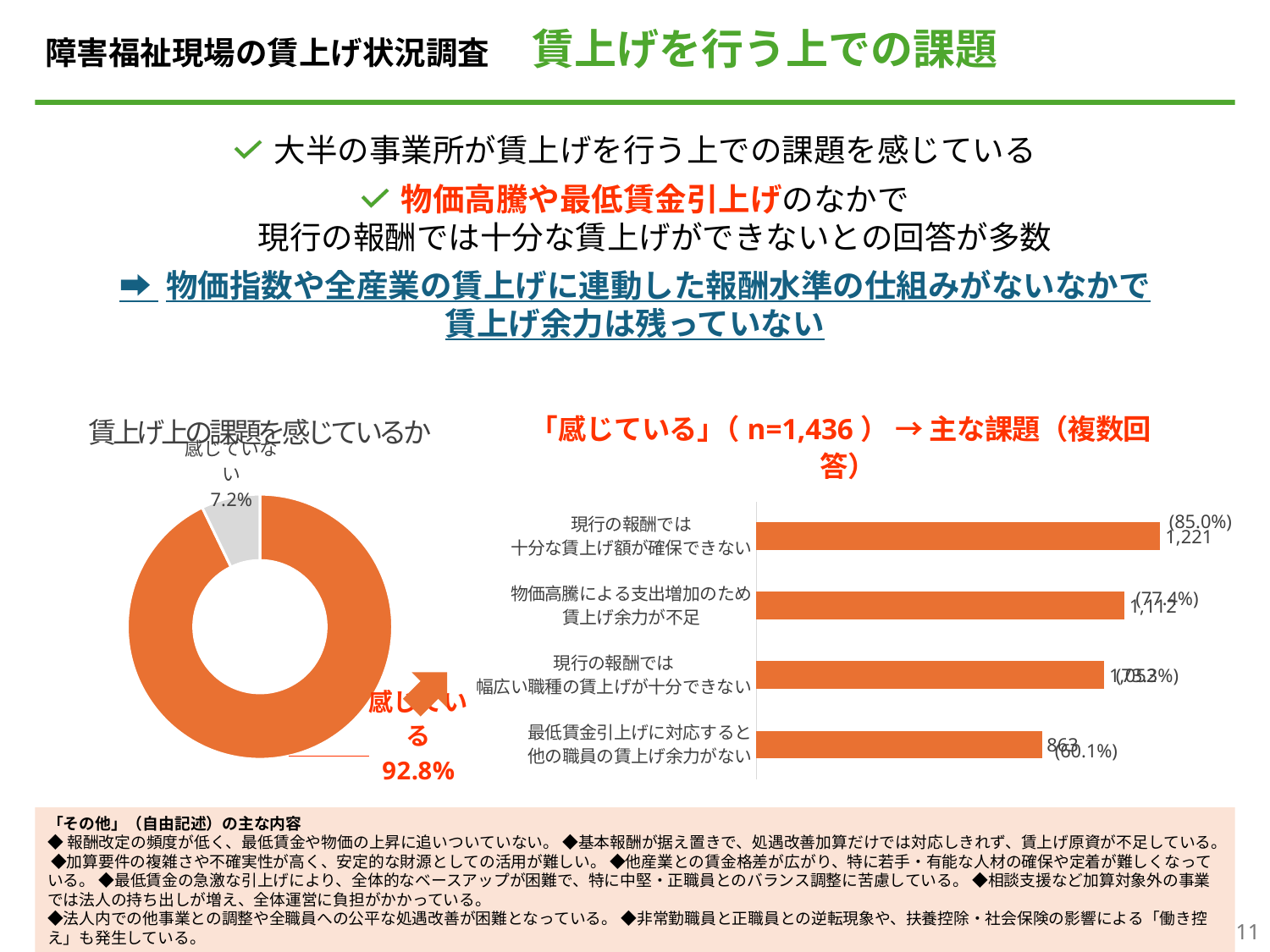
In the bar chart on the right (主な課題), what is the count for 最低賃金引上げに対応すると他の職員の賃上げ余力がない? 863 In the bar chart on the right (主な課題), which category has the lowest count? 最低賃金引上げに対応すると他の職員の賃上げ余力がない How many categories does the bar chart on the right (主な課題) show? 4 How many categories does the donut chart on the left show? 2 In the bar chart on the right (主な課題), what percentage is shown for 現行の報酬では十分な賃上げ額が確保できない? 85.0% In the donut chart on the left, which category has the larger share, 感じている or 感じていない? 感じている What kind of chart is the chart on the left of the slide? Donut (pie) chart In the bar chart on the right (主な課題), what is the count for 現行の報酬では十分な賃上げ額が確保できない? 1,221 In the bar chart on the right (主な課題), what is the difference in count between 現行の報酬では十分な賃上げ額が確保できない and 最低賃金引上げに対応すると他の職員の賃上げ余力がない? 358 In the bar chart on the right (主な課題), which category has the highest count? 現行の報酬では十分な賃上げ額が確保できない In the donut chart titled 賃上げ上の課題を感じているか, what share of respondents answered 感じていない? 7.2% In the donut chart titled 賃上げ上の課題を感じているか, what share of respondents answered 感じている? 92.8%